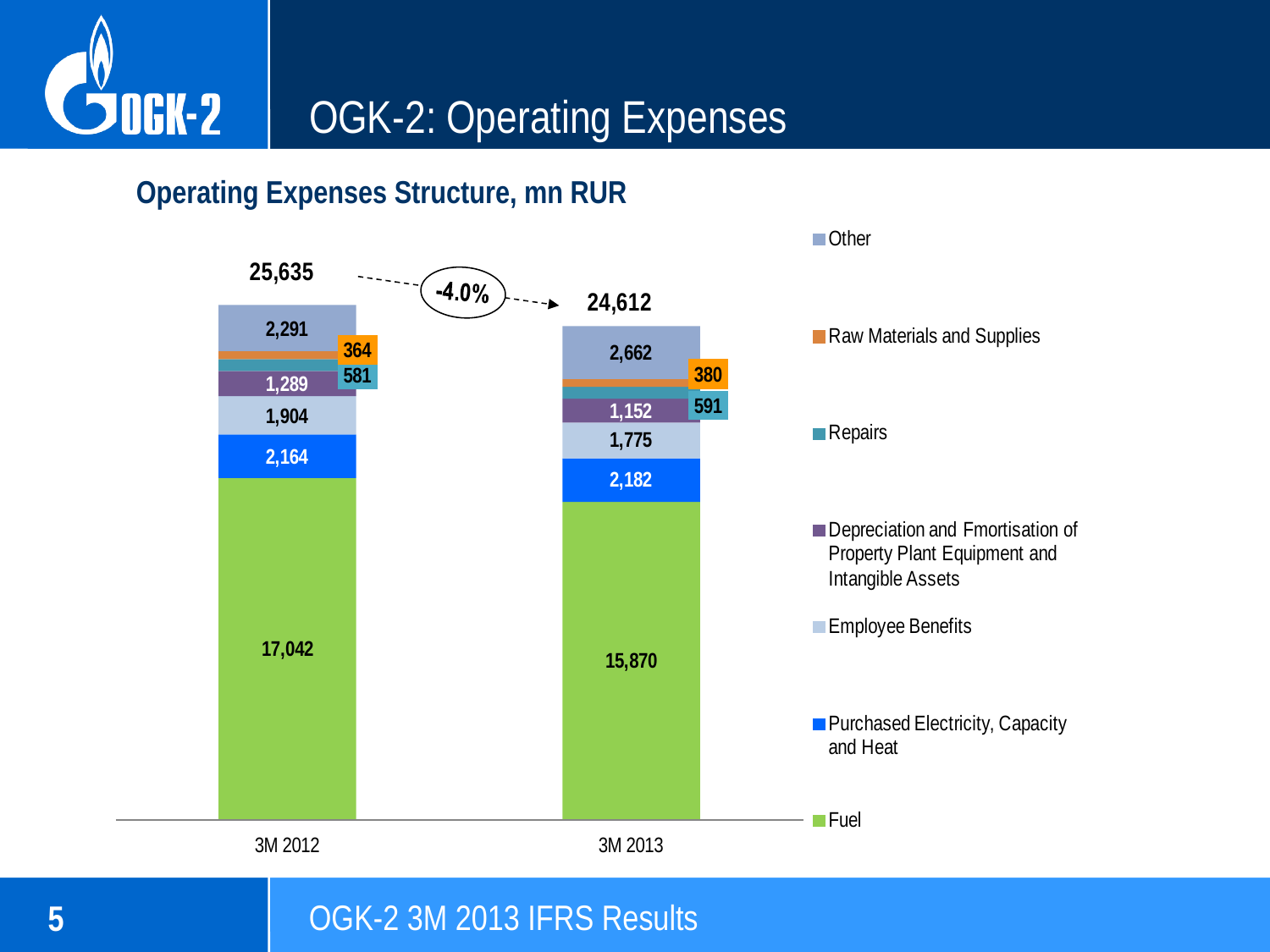
What is the Repairs value for 3M 2012? 581 What is the total of the stacked bar for 3M 2012? 25,635 What is the Employee Benefits value for 3M 2013? 1,775 What is the difference between the Fuel values for 3M 2012 and 3M 2013? 1,172 Which is larger, the Other value for 3M 2012 or for 3M 2013? 3M 2013 How many series does the legend list? 7 What is the total of the stacked bar for 3M 2013? 24,612 Which series has the highest value in the 3M 2013 bar? Fuel What is the Fuel value for 3M 2012? 17,042 Which series has the lowest value in the 3M 2012 bar? Raw Materials and Supplies What is the Fuel value for 3M 2013? 15,870 What kind of chart is shown on the slide? Stacked bar chart